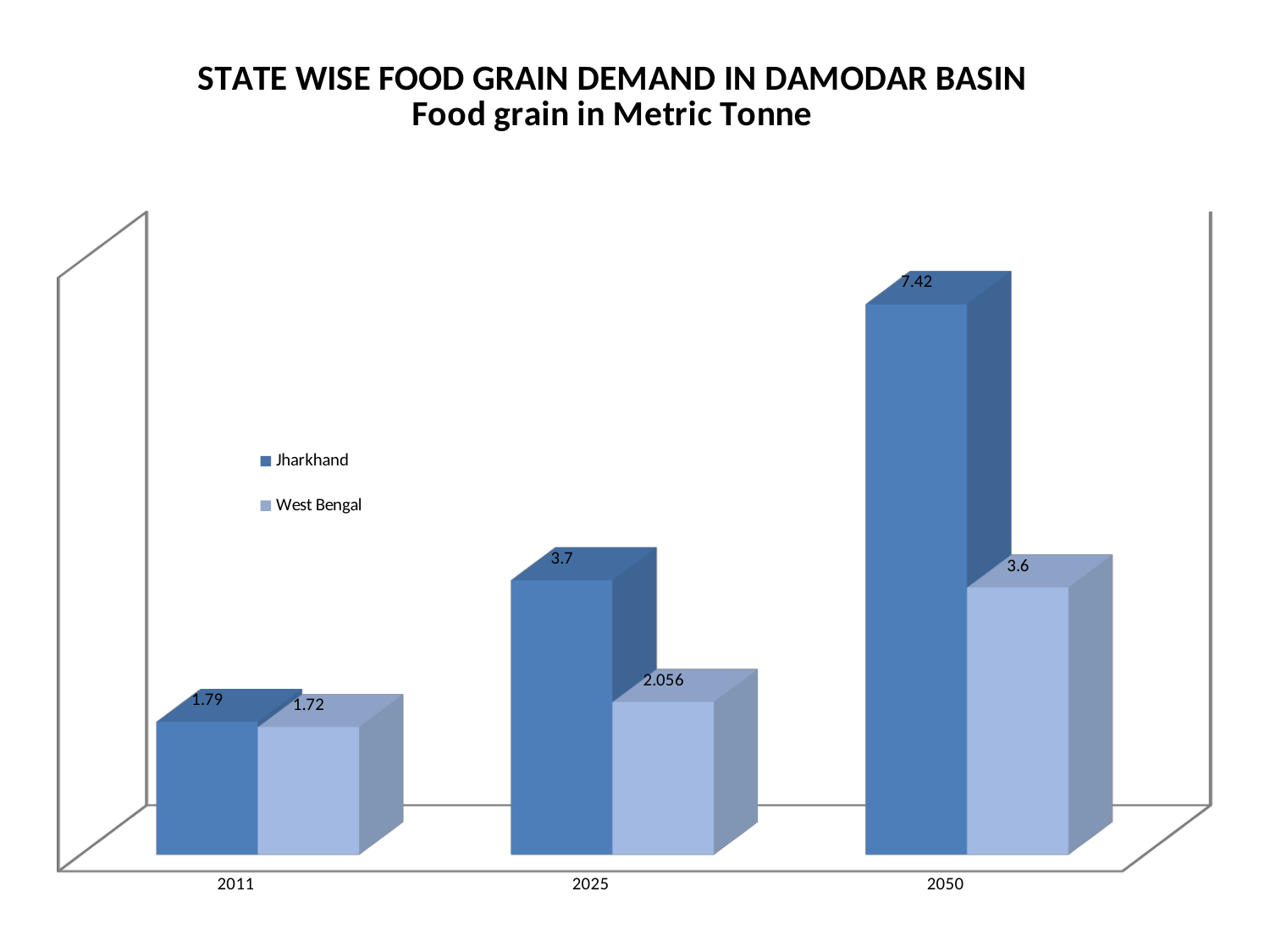
What is the food grain demand for West Bengal in 2050? 3.6 How many years are shown on the x axis? 3 In which year is the Jharkhand food grain demand highest? 2050 How many series does the legend list? 2 What is the food grain demand for West Bengal in 2025? 2.056 What is the difference between the Jharkhand and West Bengal food grain demand in 2050? 3.82 In which year is the West Bengal food grain demand lowest? 2011 What is the food grain demand for Jharkhand in 2011? 1.79 What is the food grain demand for Jharkhand in 2050? 7.42 What kind of chart is shown on the slide? Bar chart Which state has the larger food grain demand in 2025, Jharkhand or West Bengal? Jharkhand Does the Jharkhand food grain demand rise or fall from 2011 to 2050? Rise